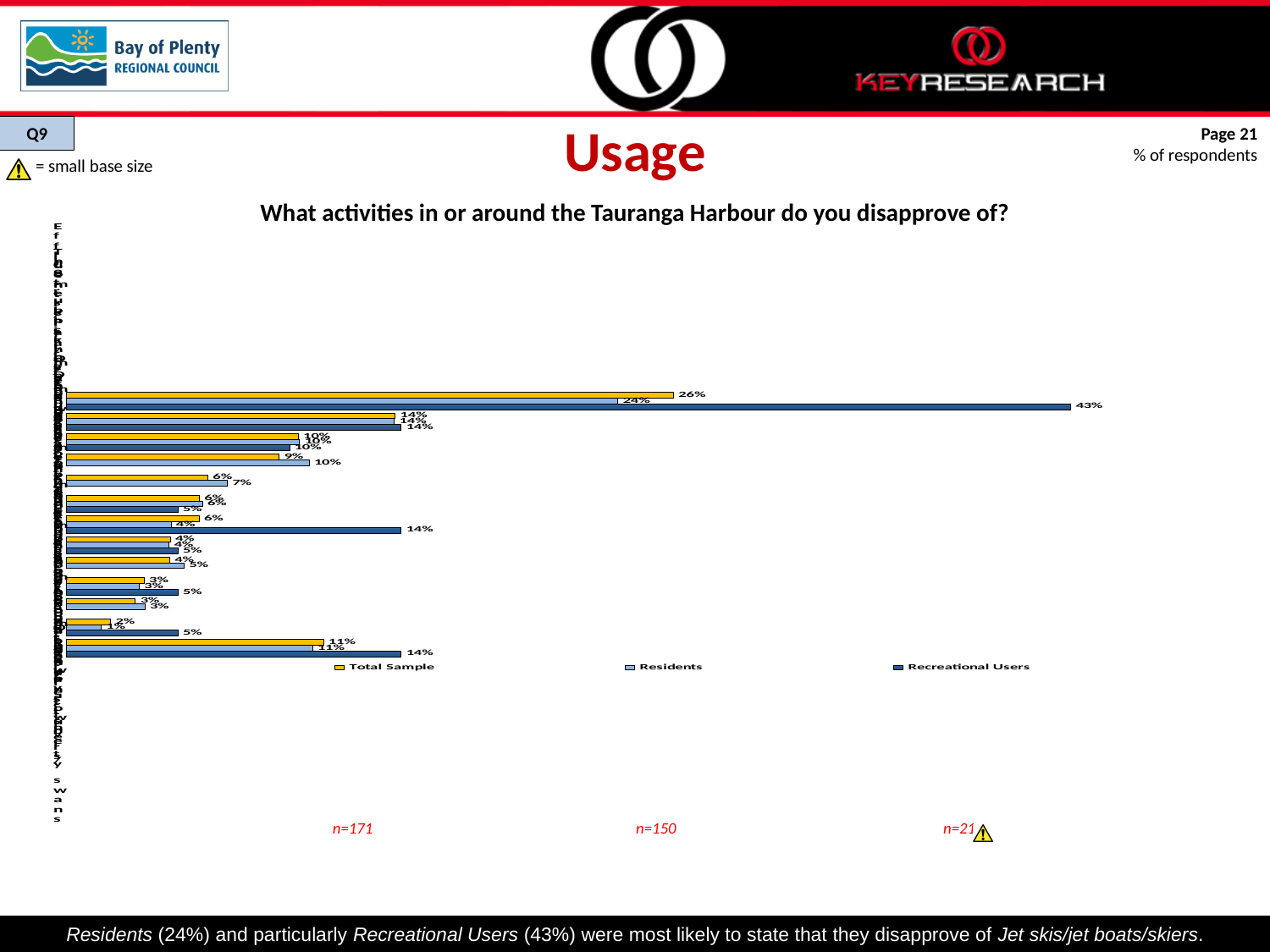
What is the highest value shown for the Residents series? 24% Is the highest Recreational Users value on the chart greater or less than 40%? greater For the topmost category on the chart, what is the difference between the Recreational Users value (43%) and the Residents value (24%)? 19 percentage points What is the title question shown above the chart? What activities in or around the Tauranga Harbour do you disapprove of? What is the highest value shown anywhere on the chart? 43% Which series does the legend list last? Recreational Users Which series has the highest single value on the chart? Recreational Users How many series does the chart legend list? 3 What kind of chart is shown on the slide? bar chart For the topmost category on the chart, which is larger: the Residents value or the Recreational Users value? Recreational Users